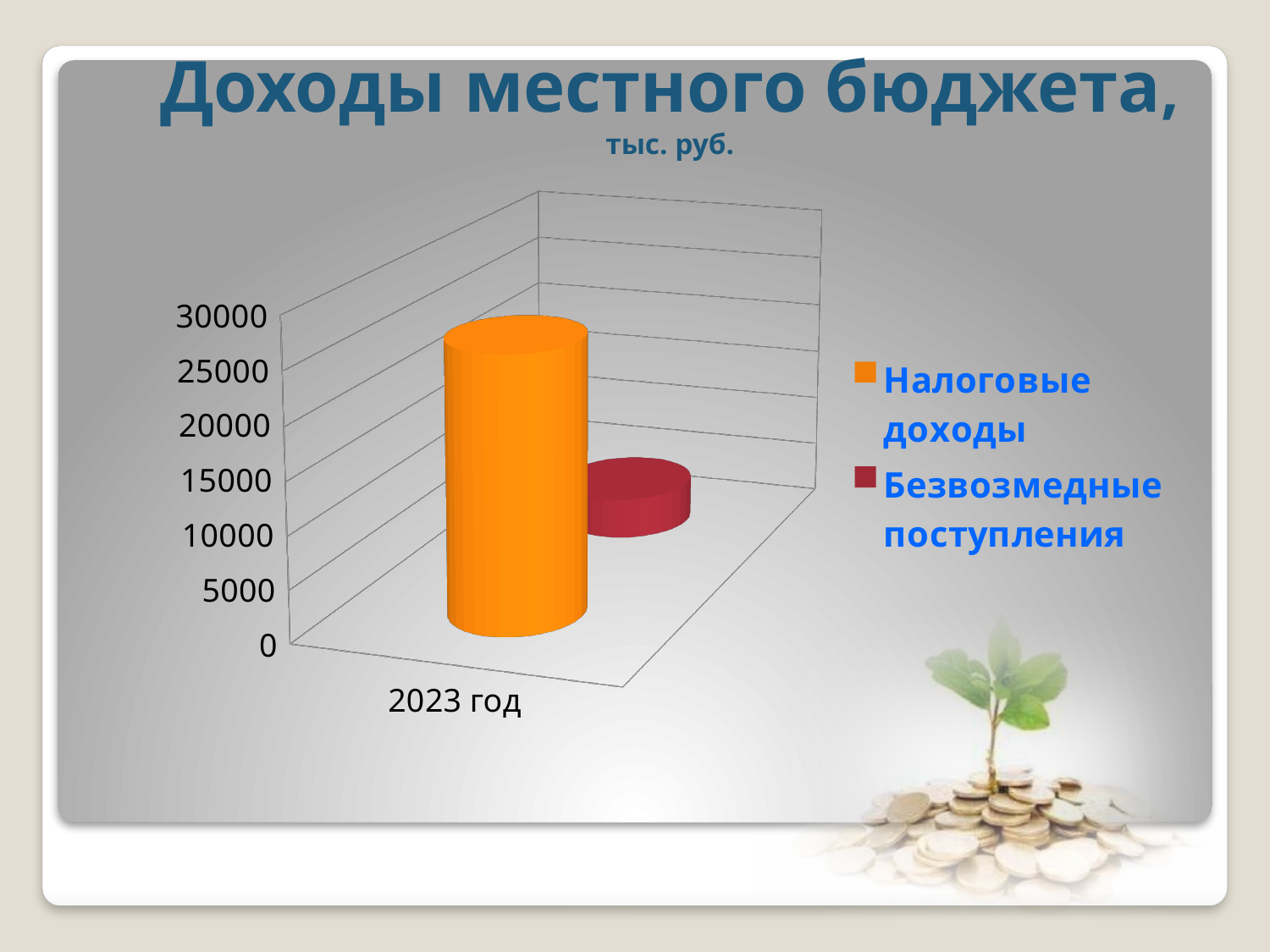
What colour represents Налоговые доходы in the chart? orange Is the value for Безвозмедные поступления greater or less than 10000? less What kind of chart is shown on the slide? bar chart How many categories are shown on the x axis? 1 What is the title of the chart? Доходы местного бюджета, тыс. руб. Which series has the highest value for 2023 год? Налоговые доходы How many series does the legend list? 2 What category label is shown on the x axis? 2023 год Is the value for Налоговые доходы greater or less than 20000? greater Which is larger for 2023 год: Налоговые доходы or Безвозмедные поступления? Налоговые доходы Which series has the lowest value for 2023 год? Безвозмедные поступления